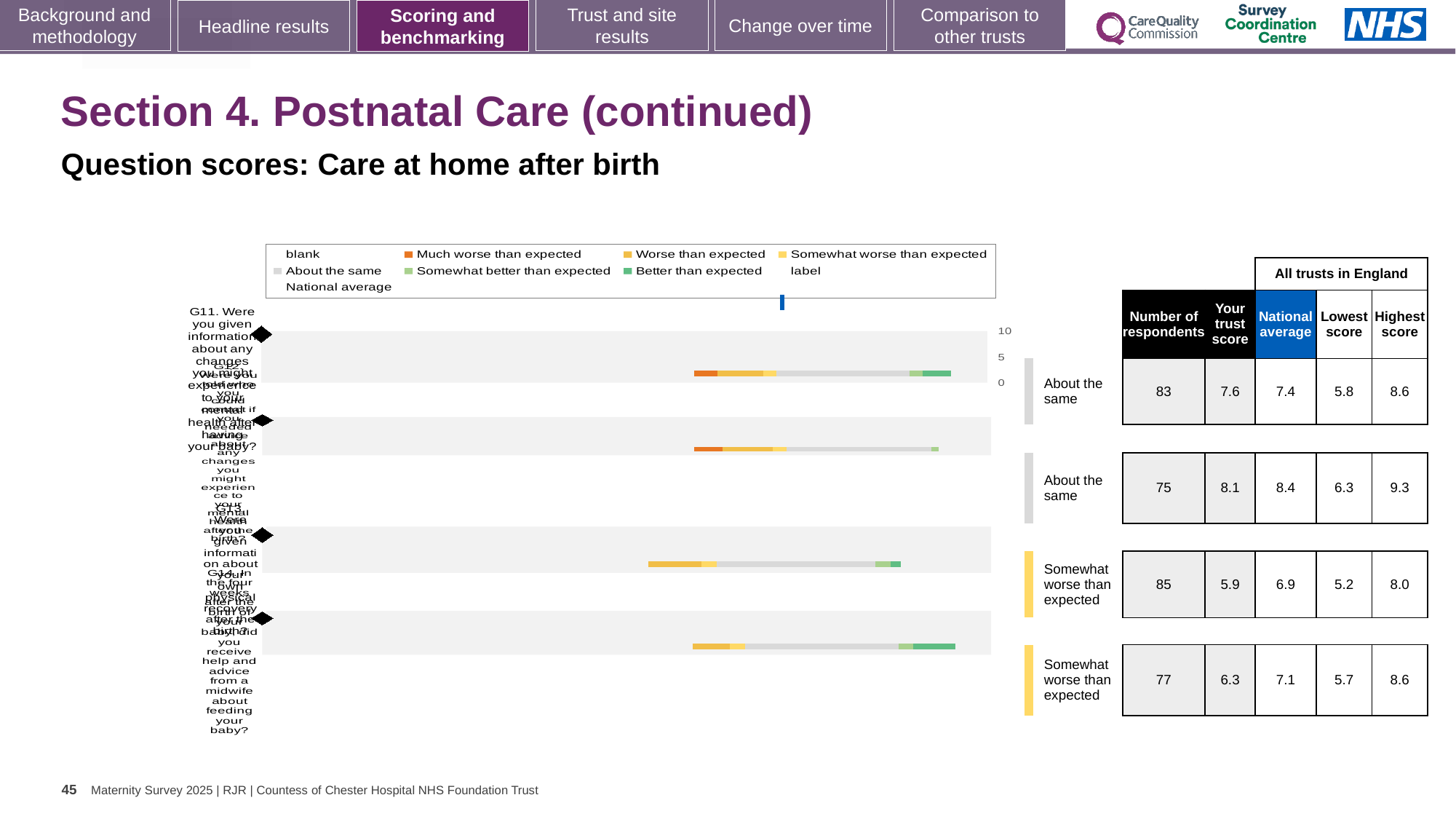
In the table beside the chart, what is the 'Your trust score' for the row with 83 respondents? 7.6 How many question rows (bars) does the chart show? 4 In the table beside the chart, what is the difference between the highest score and the lowest score for the row with 77 respondents? 2.9 Which colour does the legend use for 'Much worse than expected'? orange What is the highest value shown on the chart's axis? 10 In the table beside the chart, what is the national average for the row with 85 respondents? 6.9 In the table beside the chart, which row has the highest 'Your trust score'? the row with 75 respondents (8.1) In the table beside the chart, which row has the lowest 'Your trust score'? the row with 85 respondents (5.9) In the table beside the chart, for the row with 83 respondents, which is larger: the trust score or the national average? the trust score What kind of chart is shown on the slide? bar chart In the table beside the chart, what is the highest score for the row with 75 respondents? 9.3 In the table beside the chart, what is the benchmark category for the row with 77 respondents? Somewhat worse than expected